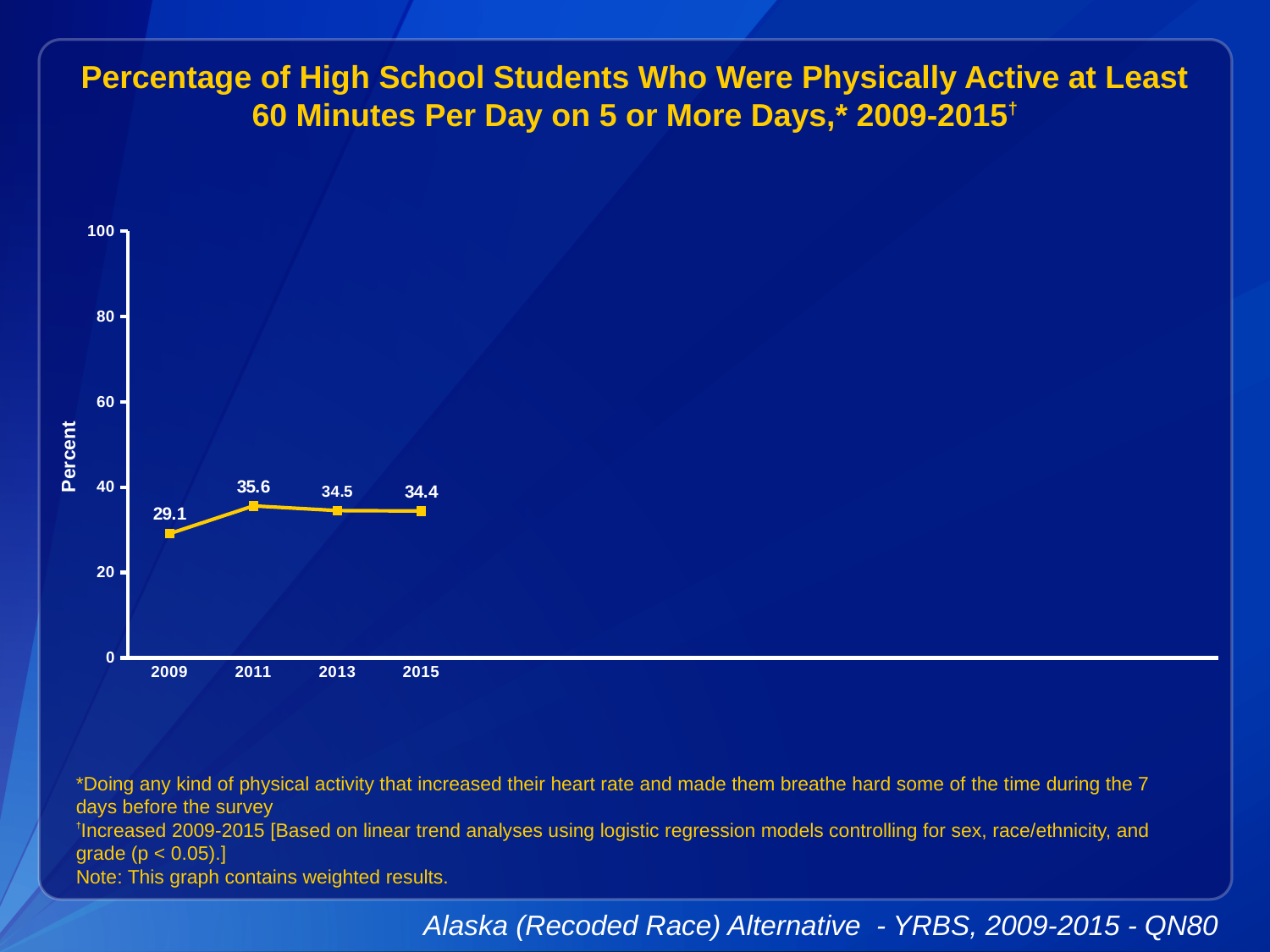
Is the value for 2011 greater or less than 40? less What kind of chart is shown on the slide? line chart What is the label on the vertical axis? Percent What value is shown for 2015? 34.4 What value is shown for 2011? 35.6 What is the difference between the 2013 value and the 2015 value? 0.1 How many years are plotted on the chart? 4 Which year has the lowest value? 2009 What is the difference between the 2011 value and the 2009 value? 6.5 Which is larger, the value for 2009 or the value for 2013? 2013 What was the percentage of high school students who were physically active at least 60 minutes per day on 5 or more days in 2009? 29.1 Which year has the highest value? 2011